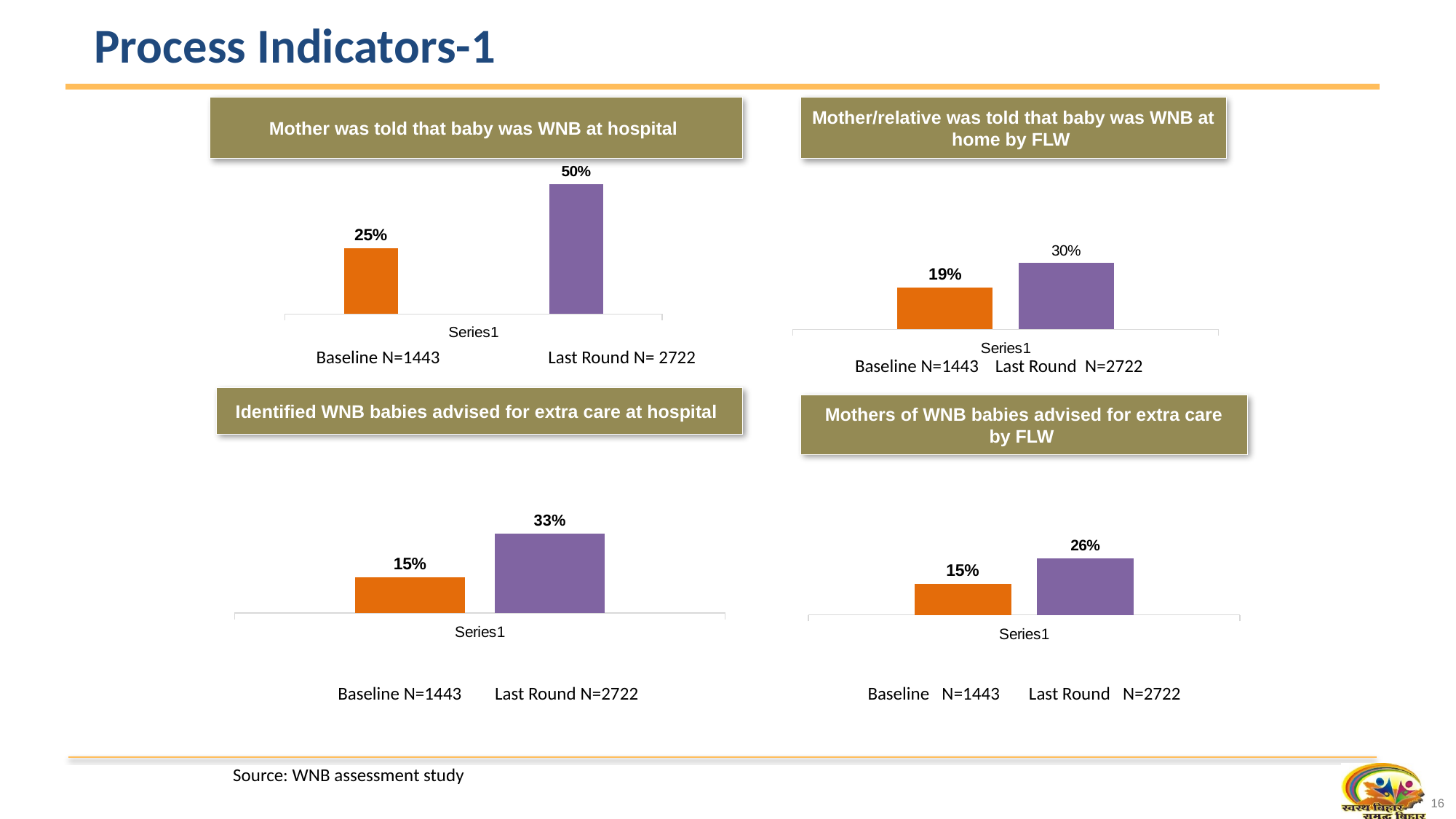
What kind of chart is the chart titled 'Identified WNB babies advised for extra care at hospital'? Bar chart In the chart titled 'Mothers of WNB babies advised for extra care by FLW', what is the value for Last Round? 26% In the chart titled 'Identified WNB babies advised for extra care at hospital', what is the difference between the Last Round and Baseline values? 18% In the chart titled 'Mother was told that baby was WNB at hospital', what is the difference between the Last Round and Baseline values? 25% In the chart titled 'Identified WNB babies advised for extra care at hospital', what is the value for Last Round? 33% In the chart titled 'Mother was told that baby was WNB at hospital', what is the value for Last Round? 50% In the chart titled 'Mother/relative was told that baby was WNB at home by FLW', what is the value for Last Round? 30% In the chart titled 'Mother was told that baby was WNB at hospital', what is the value for Baseline? 25% In the chart titled 'Mother/relative was told that baby was WNB at home by FLW', which bar is the lowest? Baseline In the chart titled 'Mothers of WNB babies advised for extra care by FLW', which is larger, Baseline or Last Round? Last Round How many bars are plotted in the chart titled 'Mothers of WNB babies advised for extra care by FLW'? 2 In the chart titled 'Mother/relative was told that baby was WNB at home by FLW', what is the value for Baseline? 19%